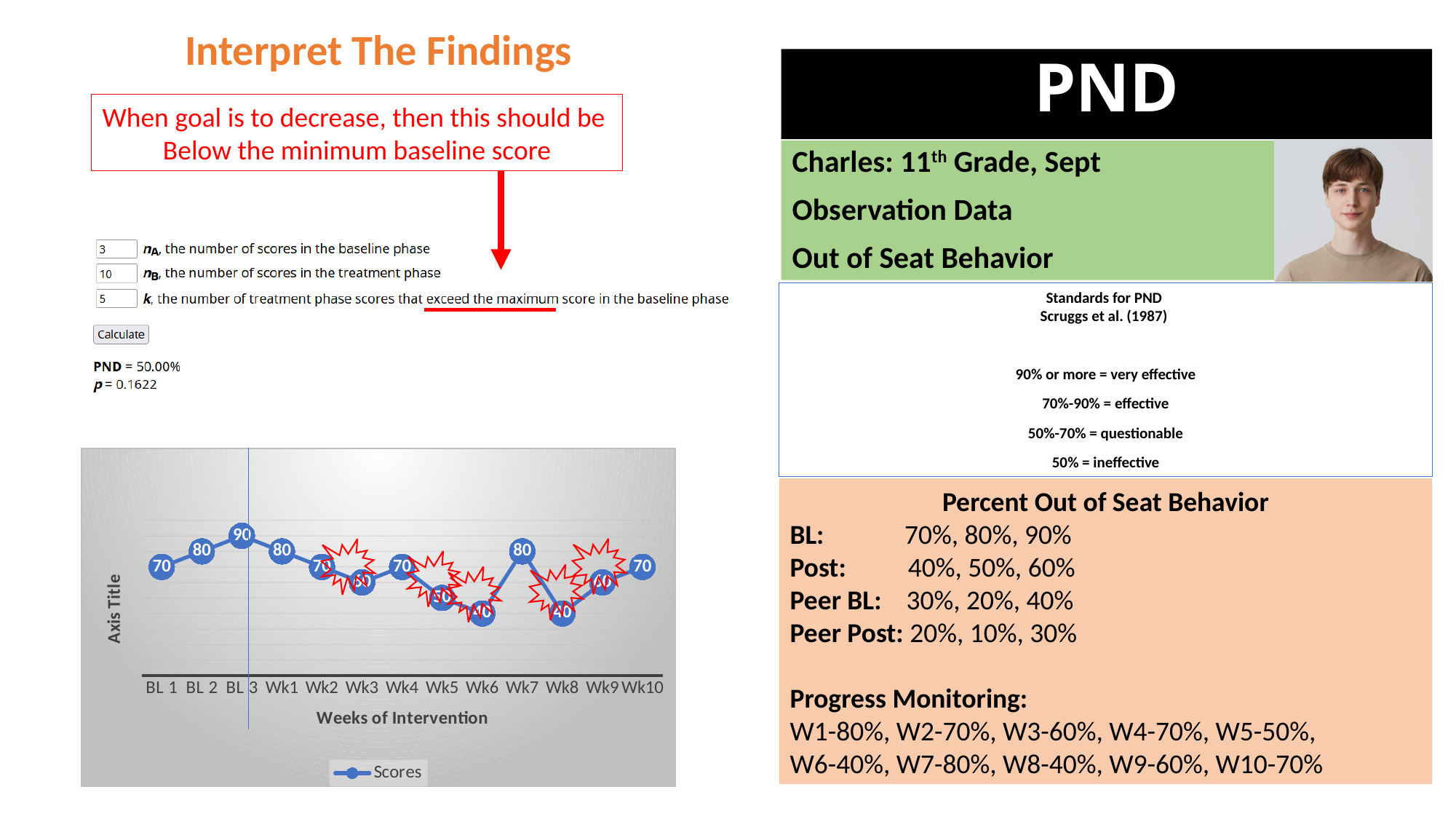
What is the difference between the score at BL 3 and the score at Wk1? 10 Which is larger, the score at Wk7 or the score at Wk4? Wk7 What is the score at BL 1? 70 What is the title of the x axis of the chart? Weeks of Intervention What is the score at Wk10? 70 How many data points are plotted on the chart? 13 What is the score at Wk7? 80 Which point on the x axis has the highest score? BL 3 How many series does the chart legend list? 1 What type of chart is shown on the slide? line chart What is the score at BL 3? 90 What is the lowest score plotted on the chart? 40